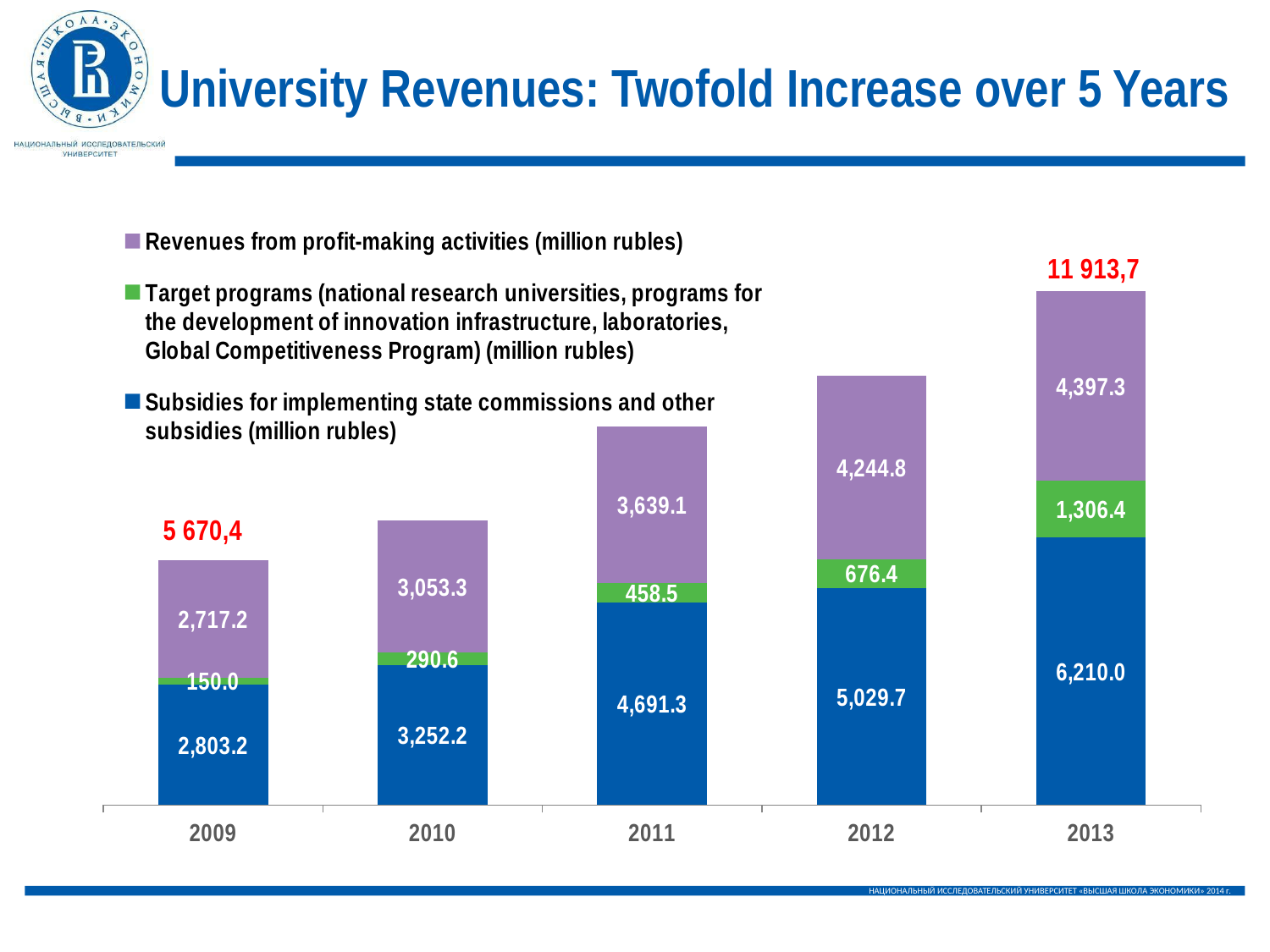
In which year is the value of target programs the lowest? 2009 In which year is the value of revenues from profit-making activities the highest? 2013 What is the difference between the subsidies value in 2013 and in 2009? 3,406.8 What is the total of the stacked bar for 2010? 6,596.1 What is the value of revenues from profit-making activities in 2010? 3,053.3 By how much did the target programs value increase from 2012 to 2013? 630.0 What is the value of subsidies for implementing state commissions and other subsidies in 2011? 4,691.3 How many years are shown on the x axis? 5 How many series does the legend list? 3 What total is printed above the 2013 bar? 11 913,7 What is the value of target programs in 2012? 676.4 Which is larger: revenues from profit-making activities in 2011 or subsidies in 2011? Subsidies in 2011